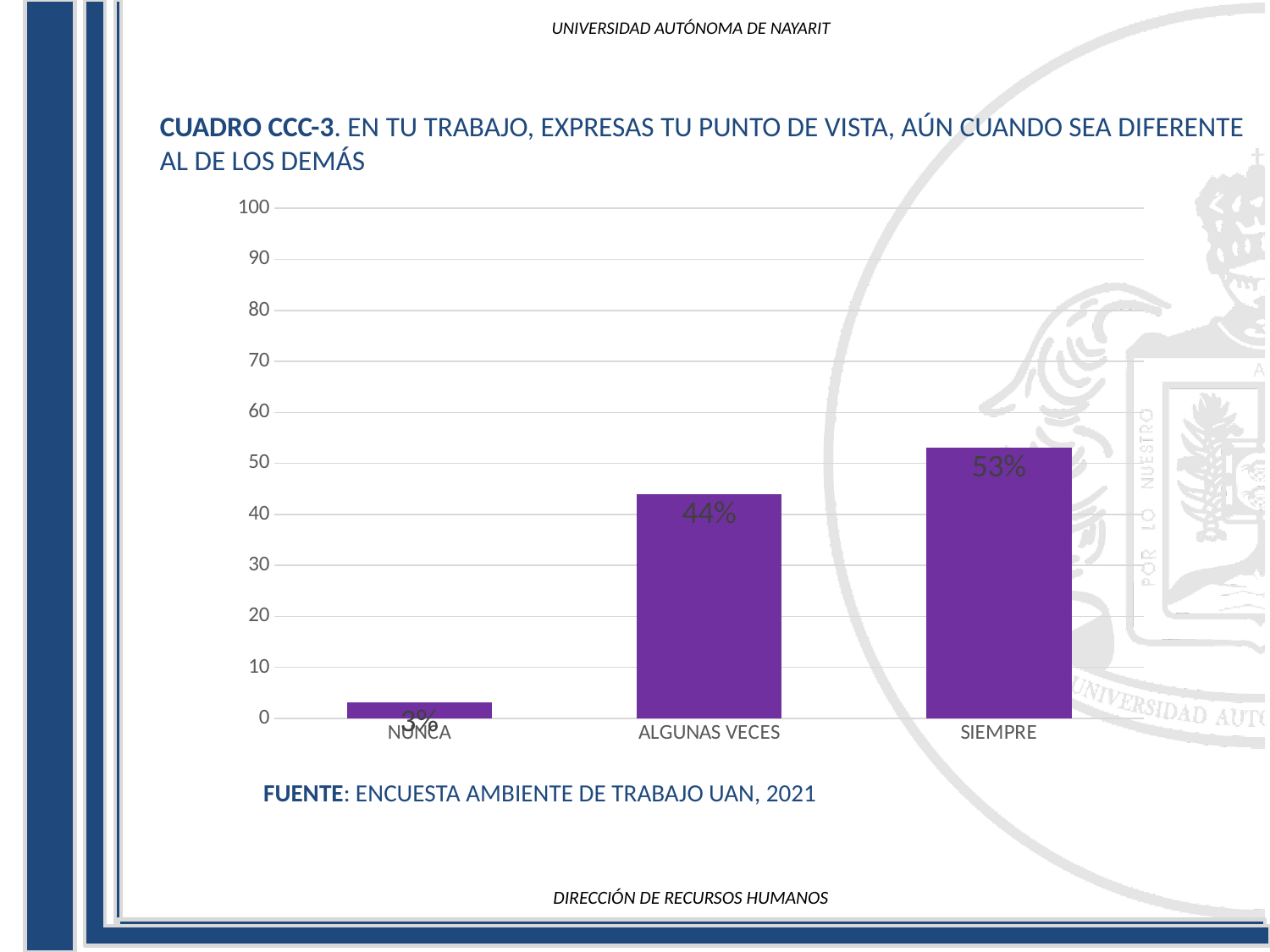
What is the value for ALGUNAS VECES? 44% Is the value for SIEMPRE greater or less than 50? greater How many categories are shown on the x axis? 3 Which is larger, the value for ALGUNAS VECES or the value for SIEMPRE? SIEMPRE What is the difference between the values for SIEMPRE and ALGUNAS VECES? 9% Which category has the lowest value? NUNCA What kind of chart is shown on the slide? bar chart What is the value for NUNCA? 3% What is the difference between the values for ALGUNAS VECES and NUNCA? 41% Do the values rise or fall from left to right along the x axis? rise What is the value for SIEMPRE? 53% Which category has the highest value? SIEMPRE